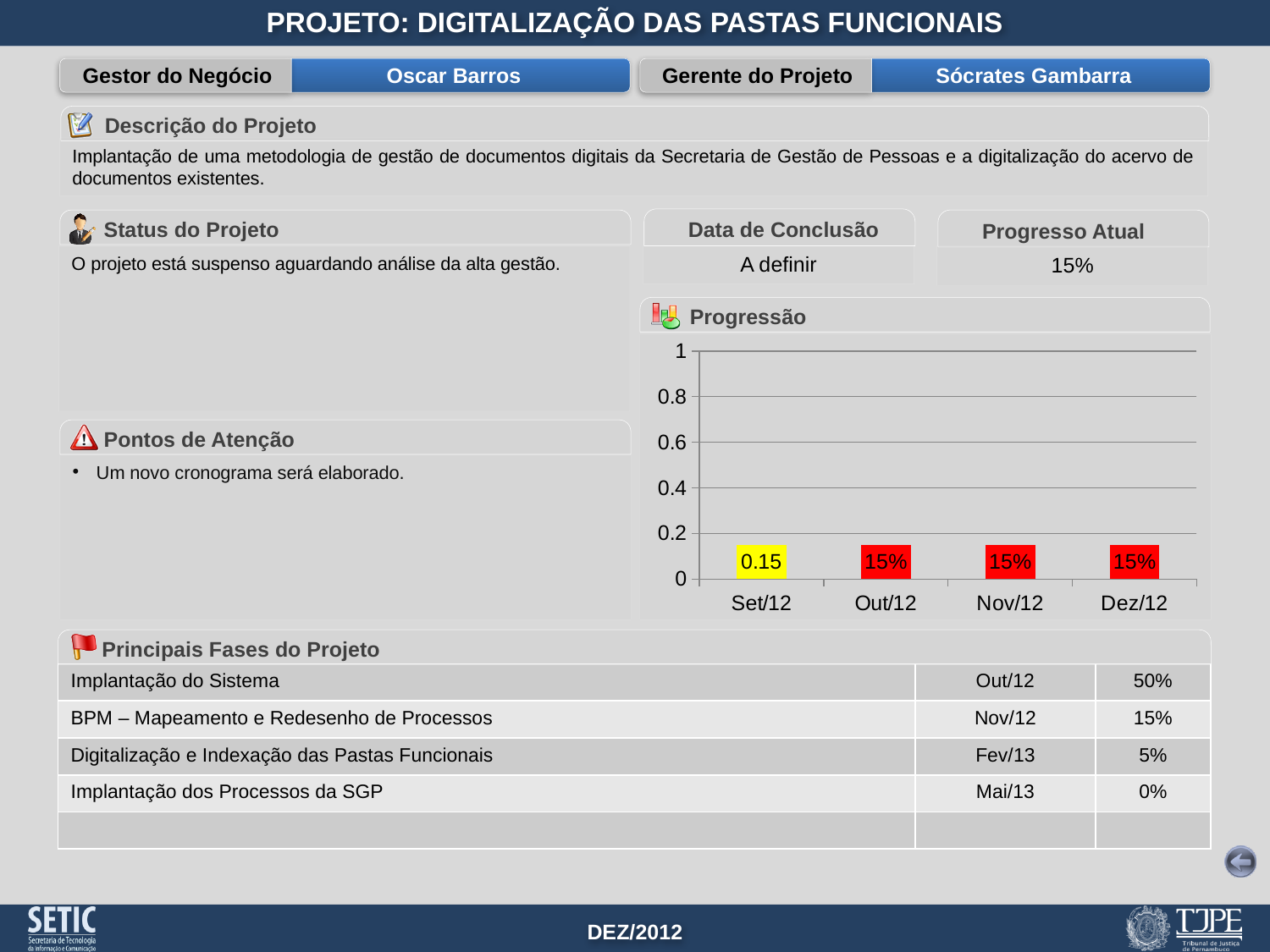
What is the data label shown for Dez/12 in the Progressão chart? 15% What is the data label shown for Nov/12 in the Progressão chart? 15% What is the highest tick value shown on the y axis of the Progressão chart? 1 How many months are plotted on the x axis of the Progressão chart? 4 Is the value for Set/12 in the Progressão chart greater or less than 0.4? less Is the value for Nov/12 in the Progressão chart greater or less than 0.2? less What is the data label shown for Set/12 in the Progressão chart? 0.15 Do the values in the Progressão chart rise, fall or stay flat from Set/12 to Dez/12? stay flat What is the title of the chart on the slide? Progressão What is the data label shown for Out/12 in the Progressão chart? 15% Which month is the first category on the x axis of the Progressão chart? Set/12 What kind of chart is the Progressão chart? bar chart